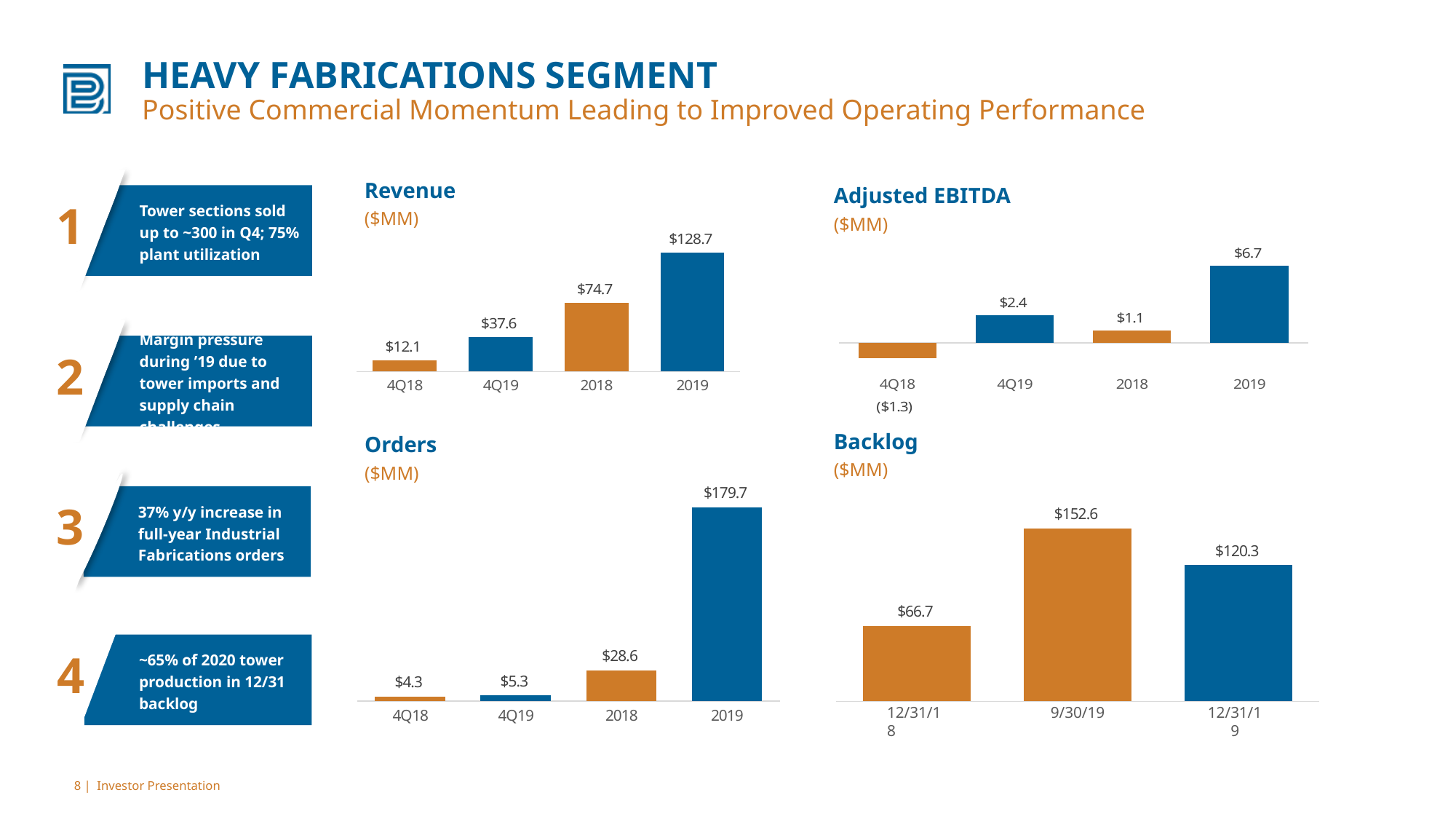
In the Revenue chart, what is the difference between the 2019 and 2018 values? $54.0 In the Adjusted EBITDA chart, which category has the highest value? 2019 In the Adjusted EBITDA chart, which is larger, 4Q19 or 2018? 4Q19 In the Revenue chart, what is the value for 4Q18? $12.1 In the Orders chart, how many categories are shown? 4 In the Backlog chart, what is the value for 9/30/19? $152.6 What kind of chart is the Backlog chart? Bar chart In the Orders chart, what is the value for 2019? $179.7 In the Adjusted EBITDA chart, what is the value for 4Q18? ($1.3) In the Backlog chart, what is the difference between the 9/30/19 and 12/31/19 values? $32.3 In the Revenue chart, what is the value for 2019? $128.7 In the Orders chart, which category has the lowest value? 4Q18